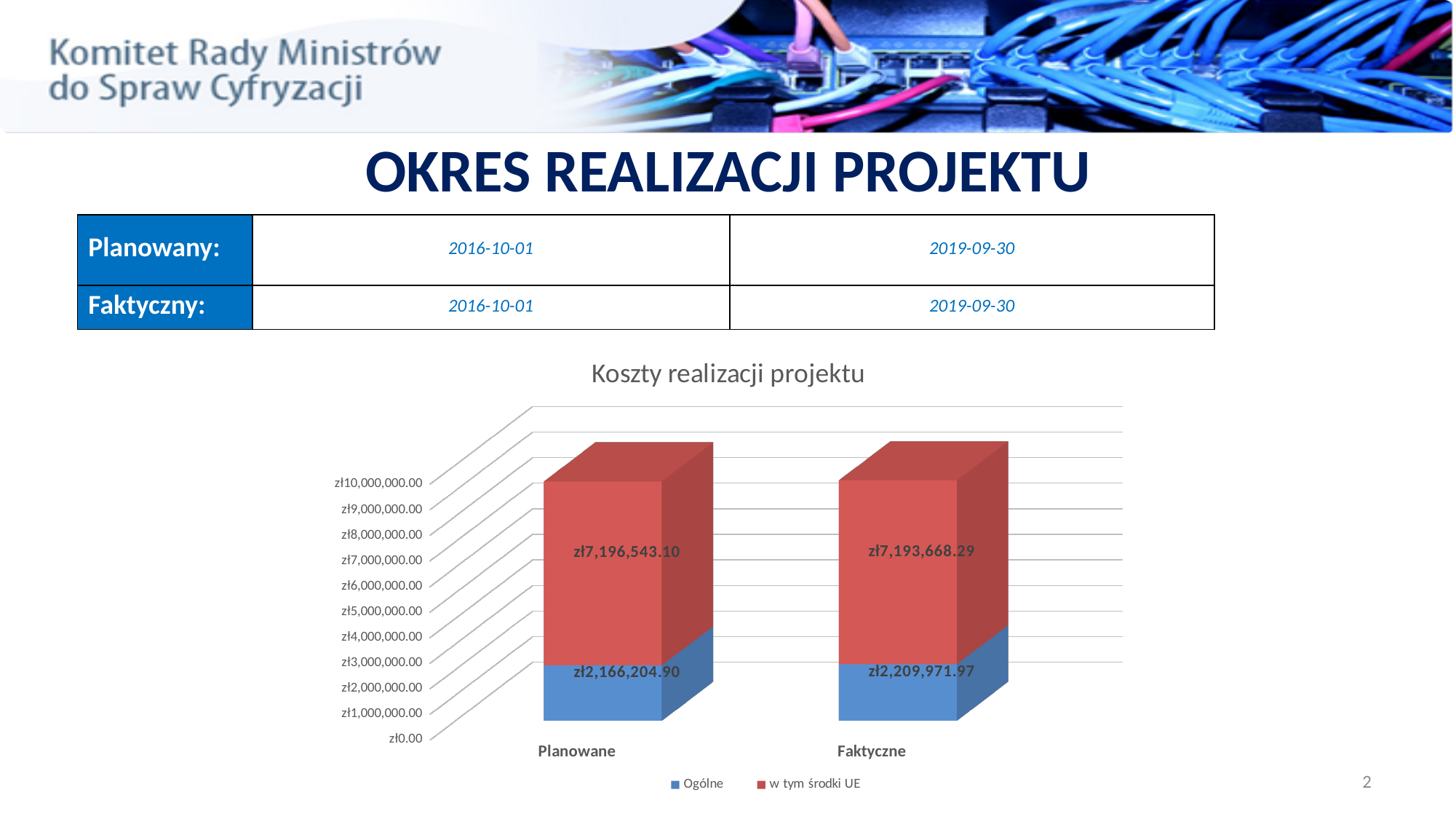
How many series does the chart legend list? 2 What is the value of 'Ogólne' for Planowane? zł2,166,204.90 What is the title of the chart? Koszty realizacji projektu What is the value of 'Ogólne' for Faktyczne? zł2,209,971.97 What is the difference between the 'Ogólne' values for Faktyczne and Planowane? zł43,767.07 Which category has the larger 'Ogólne' value, Planowane or Faktyczne? Faktyczne How many categories are shown on the x axis of the chart? 2 What is the value of 'w tym środki UE' for Planowane? zł7,196,543.10 What is the total of the stacked bar for Planowane? zł9,362,748.00 What is the difference between the 'w tym środki UE' values for Planowane and Faktyczne? zł2,874.81 What is the total of the stacked bar for Faktyczne? zł9,403,640.26 What is the value of 'w tym środki UE' for Faktyczne? zł7,193,668.29